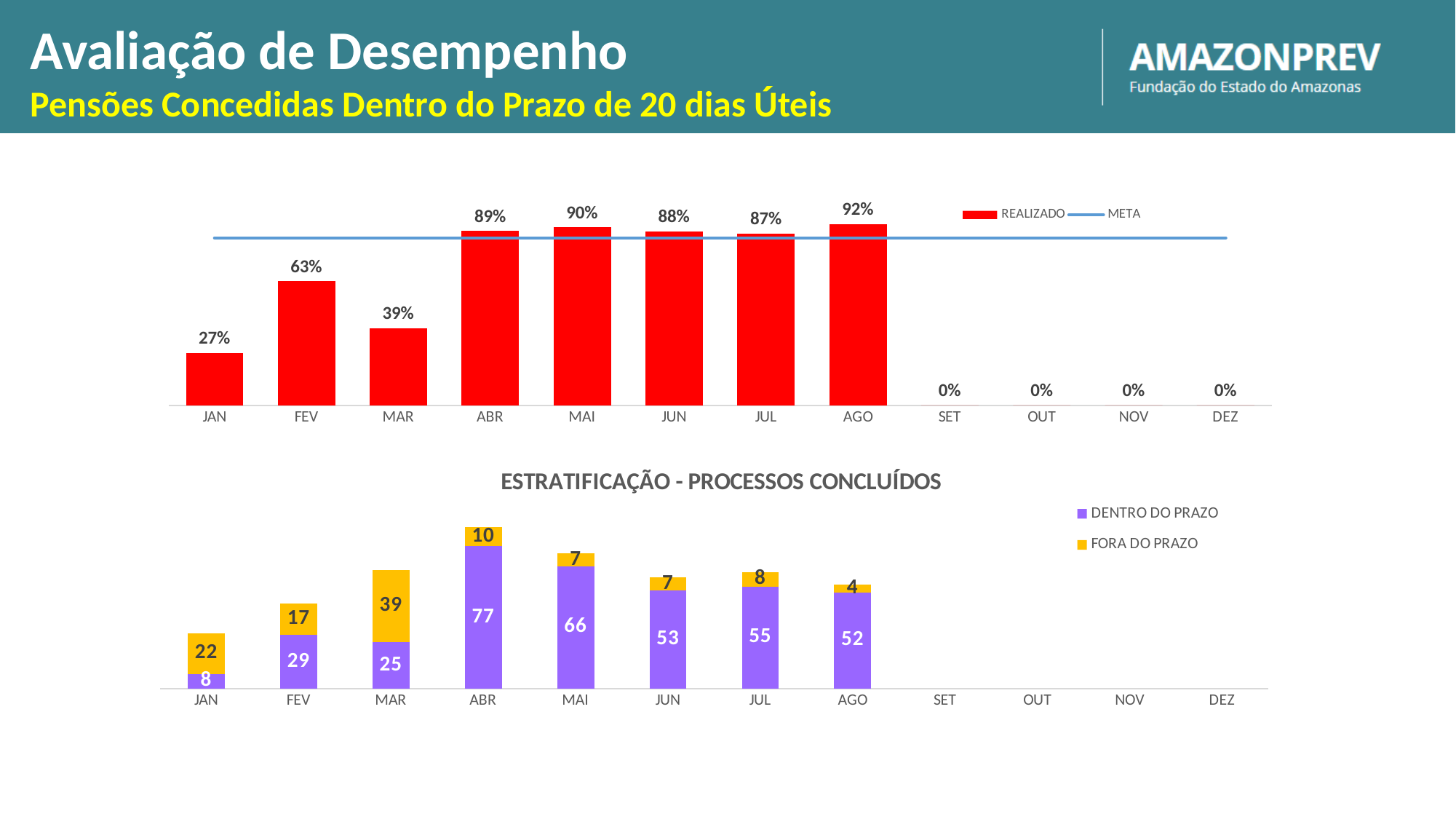
In the chart titled ESTRATIFICAÇÃO - PROCESSOS CONCLUÍDOS, what colour represents FORA DO PRAZO? yellow In the chart titled ESTRATIFICAÇÃO - PROCESSOS CONCLUÍDOS, what is the total of the stacked bar for JAN? 30 In the top chart, what is the REALIZADO value for FEV? 63% In the chart titled ESTRATIFICAÇÃO - PROCESSOS CONCLUÍDOS, what is the DENTRO DO PRAZO value for ABR? 77 In the top chart, which is larger, the REALIZADO value for MAR or for FEV? FEV In the top chart, which month has the highest REALIZADO value? AGO In the chart titled ESTRATIFICAÇÃO - PROCESSOS CONCLUÍDOS, what kind of chart is shown? stacked bar chart In the top chart, how many series does the legend list? 2 In the top chart, what is the difference between the REALIZADO values for ABR and JAN? 62% In the top chart, do the REALIZADO values rise or fall from JAN to FEV? rise In the chart titled ESTRATIFICAÇÃO - PROCESSOS CONCLUÍDOS, what is the FORA DO PRAZO value for MAR? 39 In the chart titled ESTRATIFICAÇÃO - PROCESSOS CONCLUÍDOS, which month has the highest DENTRO DO PRAZO value? ABR